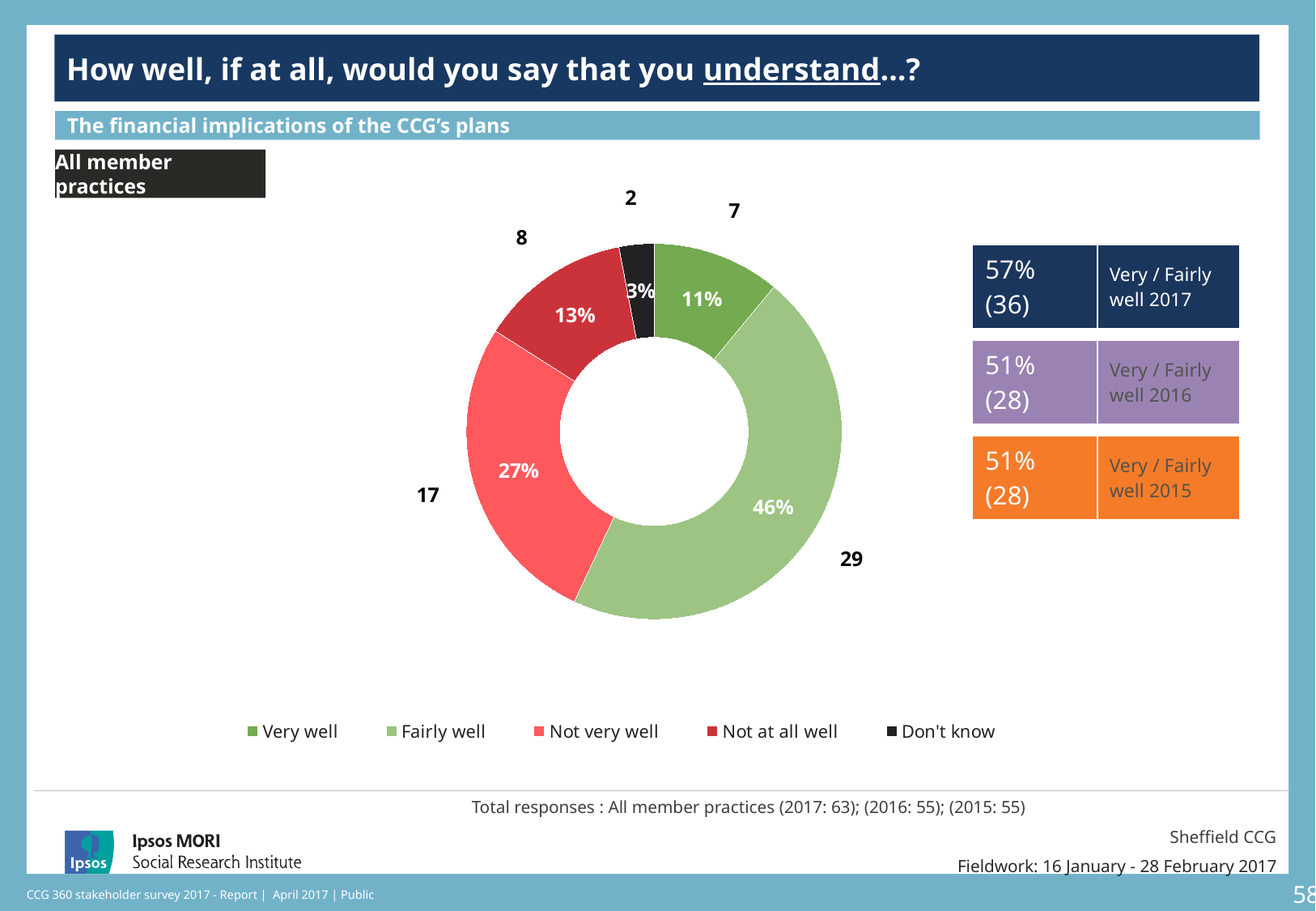
Which response category has the smallest share of the pie? Don't know What is the difference in percentage points between 'Fairly well' and 'Not very well'? 19 What percentage of respondents answered 'Don't know'? 3% Which response category has the largest share of the pie? Fairly well How many response categories does the legend list? 5 What percentage of respondents answered 'Very well'? 11% How many respondents answered 'Not at all well'? 8 What percentage of respondents said they understand the financial implications of the CCG's plans 'Fairly well'? 46% What was the combined 'Very / Fairly well' percentage in 2017? 57% What percentage of respondents answered 'Not very well'? 27% Which is larger, the share for 'Not at all well' or the share for 'Very well'? Not at all well What kind of chart is shown on the slide? Pie chart (doughnut)